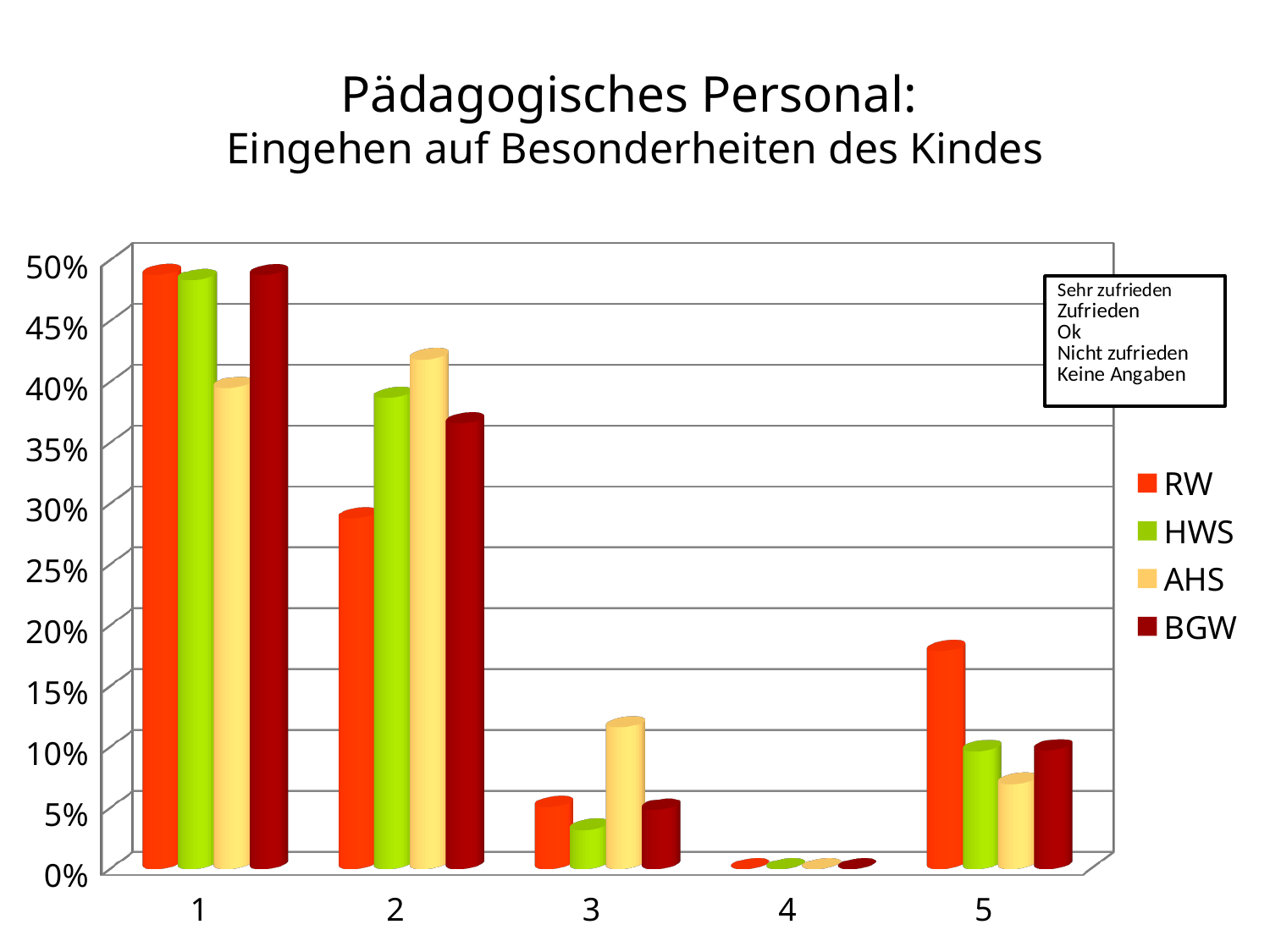
Is the value for RW in category 5 greater or less than 15%? greater What kind of chart is shown on the slide? bar chart Is the value for AHS in category 1 greater or less than 45%? less Is the value for RW in category 1 greater or less than 45%? greater Which series has the highest value in category 5? RW In category 2, which is larger: the value for RW or the value for AHS? AHS What is the title of the chart? Pädagogisches Personal: Eingehen auf Besonderheiten des Kindes How many categories are shown on the x axis? 5 Which series has the highest value in category 3? AHS How many series does the legend list? 4